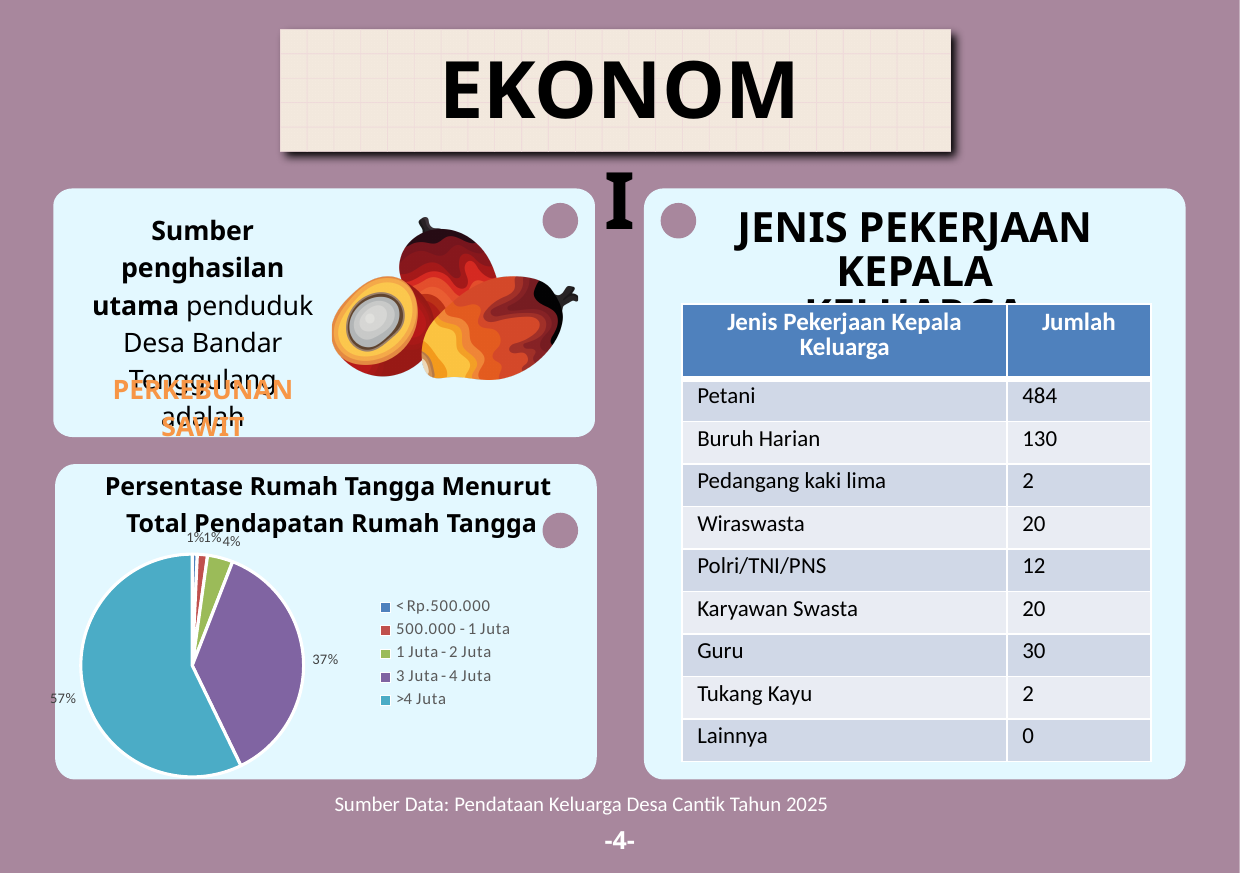
What is the title of the pie chart? Persentase Rumah Tangga Menurut Total Pendapatan Rumah Tangga Which income category has the largest share of households? >4 Juta What kind of chart is shown on the slide? pie chart What percentage of households have a total income of 3 Juta - 4 Juta? 37% What percentage of households have a total income of 1 Juta - 2 Juta? 4% What percentage of households have a total income of >4 Juta? 57% What is the difference in percentage points between the >4 Juta slice and the 3 Juta - 4 Juta slice? 20 How many income categories does the pie chart show? 5 What colour is the >4 Juta slice in the pie chart? teal (blue-green) How many entries does the legend of the pie chart list? 5 What percentage of households have a total income of < Rp.500.000? 1% Which is larger: the share for 3 Juta - 4 Juta or the share for 1 Juta - 2 Juta? 3 Juta - 4 Juta